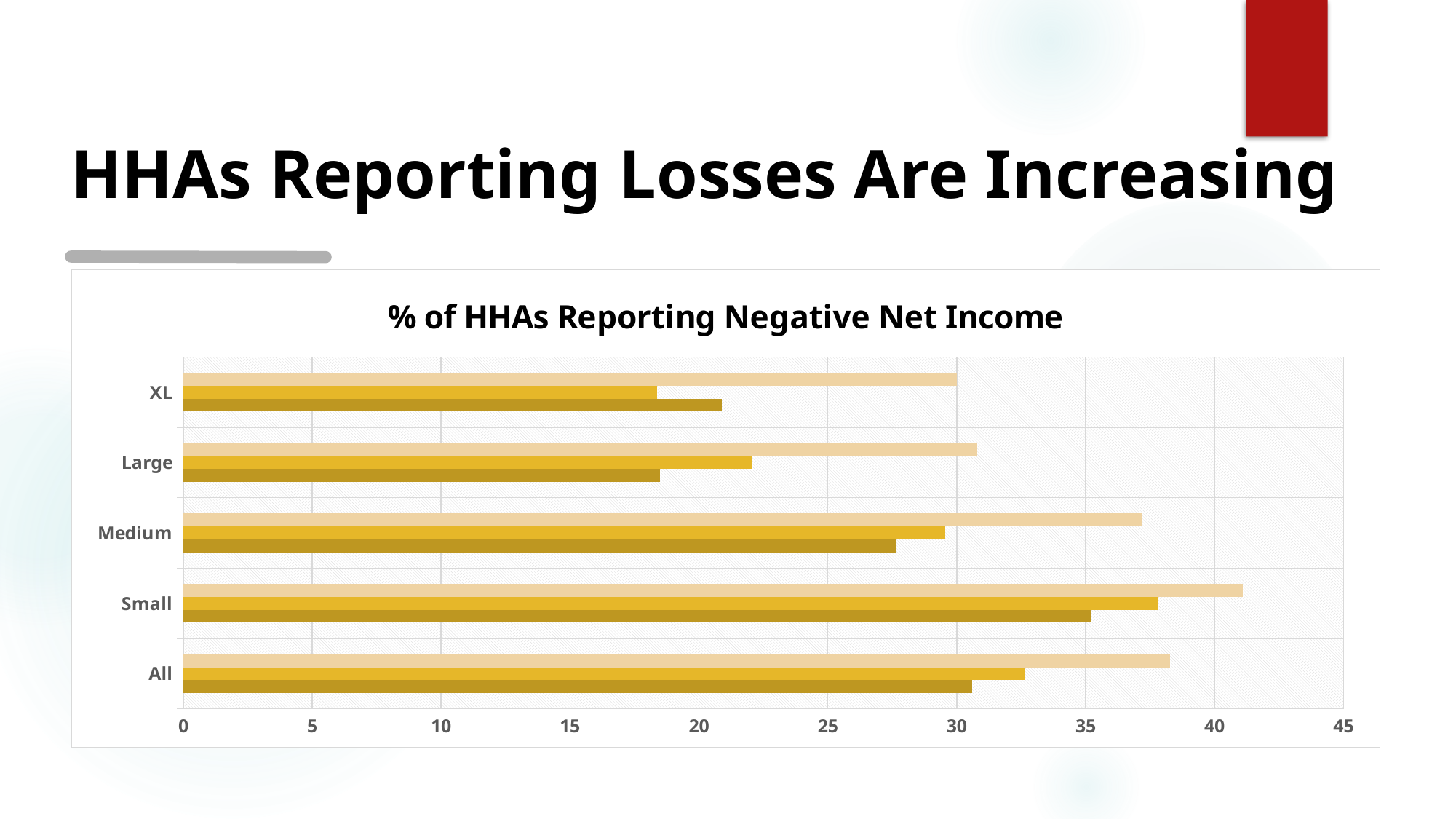
Which is larger: the darkest-coloured bar for Small or the darkest-coloured bar for XL? Small What is the highest value shown on the horizontal axis of the chart? 45 How many categories are shown on the vertical axis of the chart? 5 Which is larger: the lightest-coloured bar for Medium or the lightest-coloured bar for Large? Medium What is the title of the chart? % of HHAs Reporting Negative Net Income Which category has the longest lightest-coloured bar? Small Which category has the longest darkest-coloured bar? Small Is the lightest-coloured bar for All greater or less than 35? greater Is the lightest-coloured bar for Small greater or less than 35? greater Is the darkest-coloured bar for XL greater or less than 25? less How many bars are plotted for each category in the chart? 3 What kind of chart is shown on the slide? bar chart